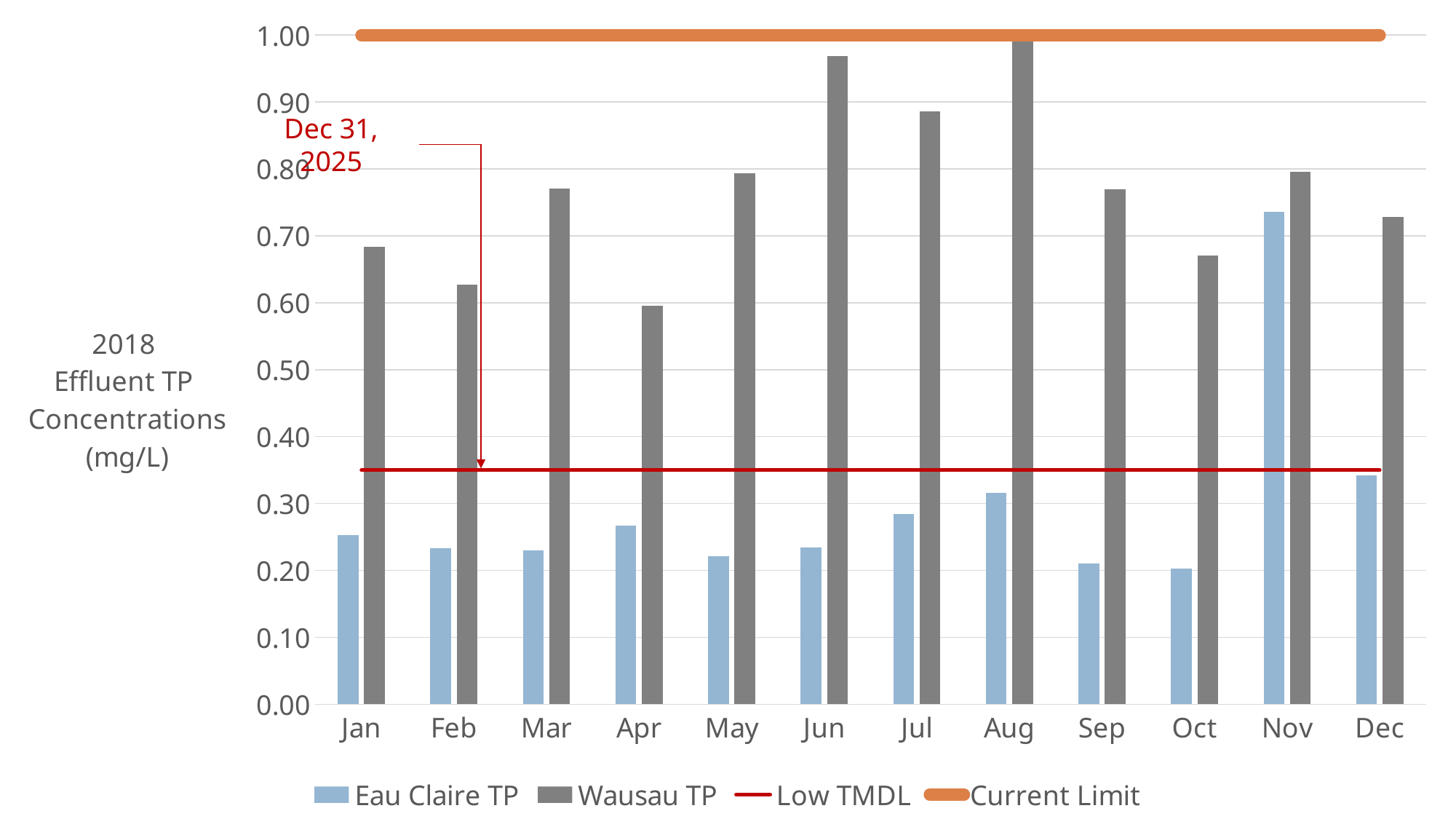
Is the Wausau TP value for Jun greater or less than 0.90? greater What is the y-axis title of the chart? 2018 Effluent TP Concentrations (mg/L) Which month has the highest Eau Claire TP value? Nov What kind of chart is shown on the slide? bar chart Do the Eau Claire TP values rise or fall from Aug to Oct? fall What value does the Current Limit line sit at? 1.00 In Nov, which is larger: the Eau Claire TP value or the Wausau TP value? Wausau TP Is the Wausau TP value for Jan greater or less than 0.70? less How many months are shown along the x axis? 12 Is the Eau Claire TP value for Dec greater or less than 0.30? greater How many entries does the legend list? 4